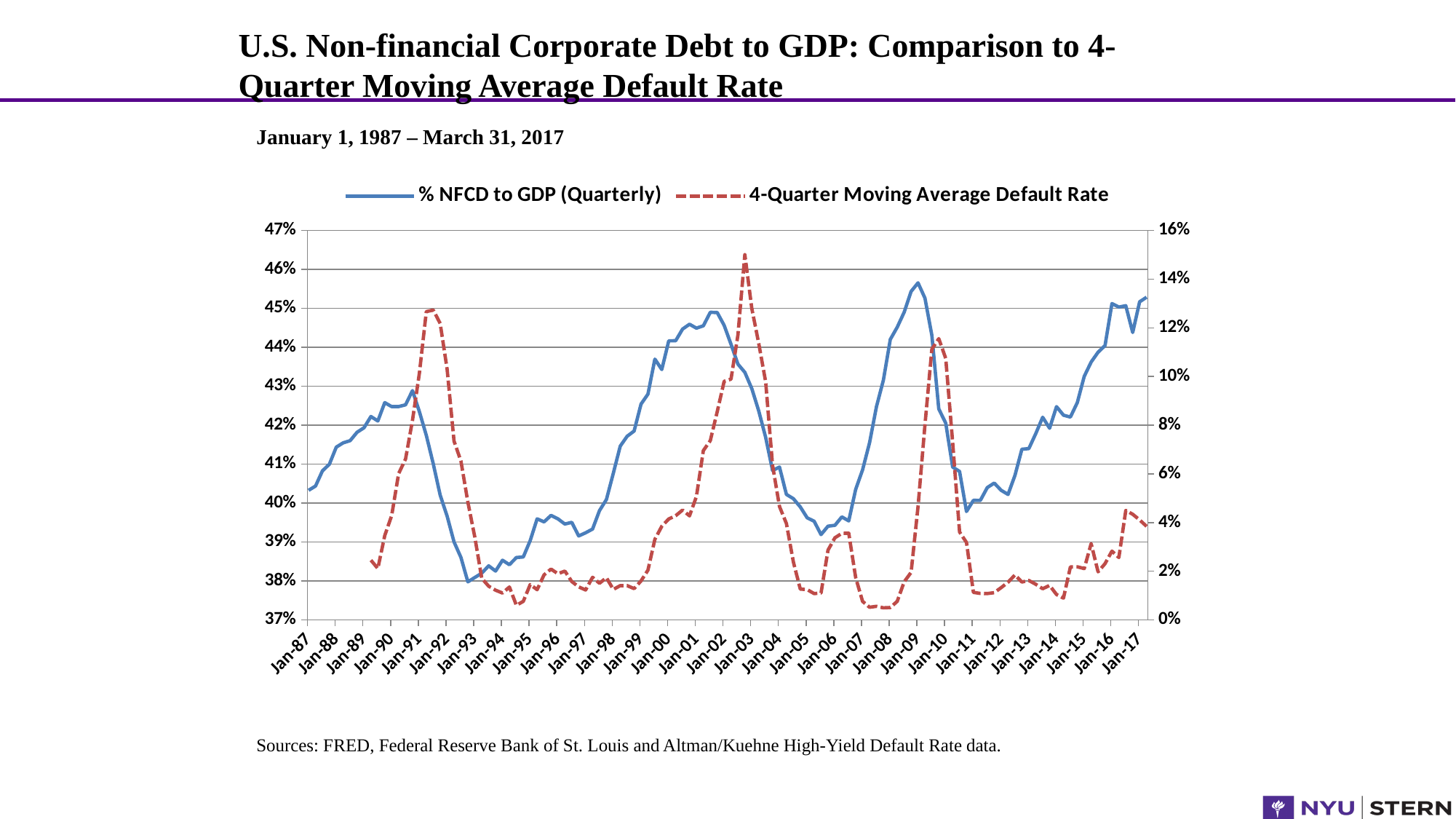
How many series does the legend list? 2 Around which x-axis label does the 4-Quarter Moving Average Default Rate reach its highest point? Jan-03 What kind of chart is shown on the slide? Line chart How many year labels are shown on the x axis? 31 Is the 4-Quarter Moving Average Default Rate at Jan-03 greater or less than 14%? less Around which x-axis label does the % NFCD to GDP (Quarterly) series reach its highest point? Jan-09 Is the % NFCD to GDP (Quarterly) value at Jan-93 greater or less than 39%? less Is the 4-Quarter Moving Average Default Rate at Jan-07 greater or less than 2%? less Which series is drawn with a dashed line? 4-Quarter Moving Average Default Rate What is the date range stated above the chart? January 1, 1987 – March 31, 2017 Does the % NFCD to GDP (Quarterly) series rise or fall between Jan-11 and Jan-17? rise